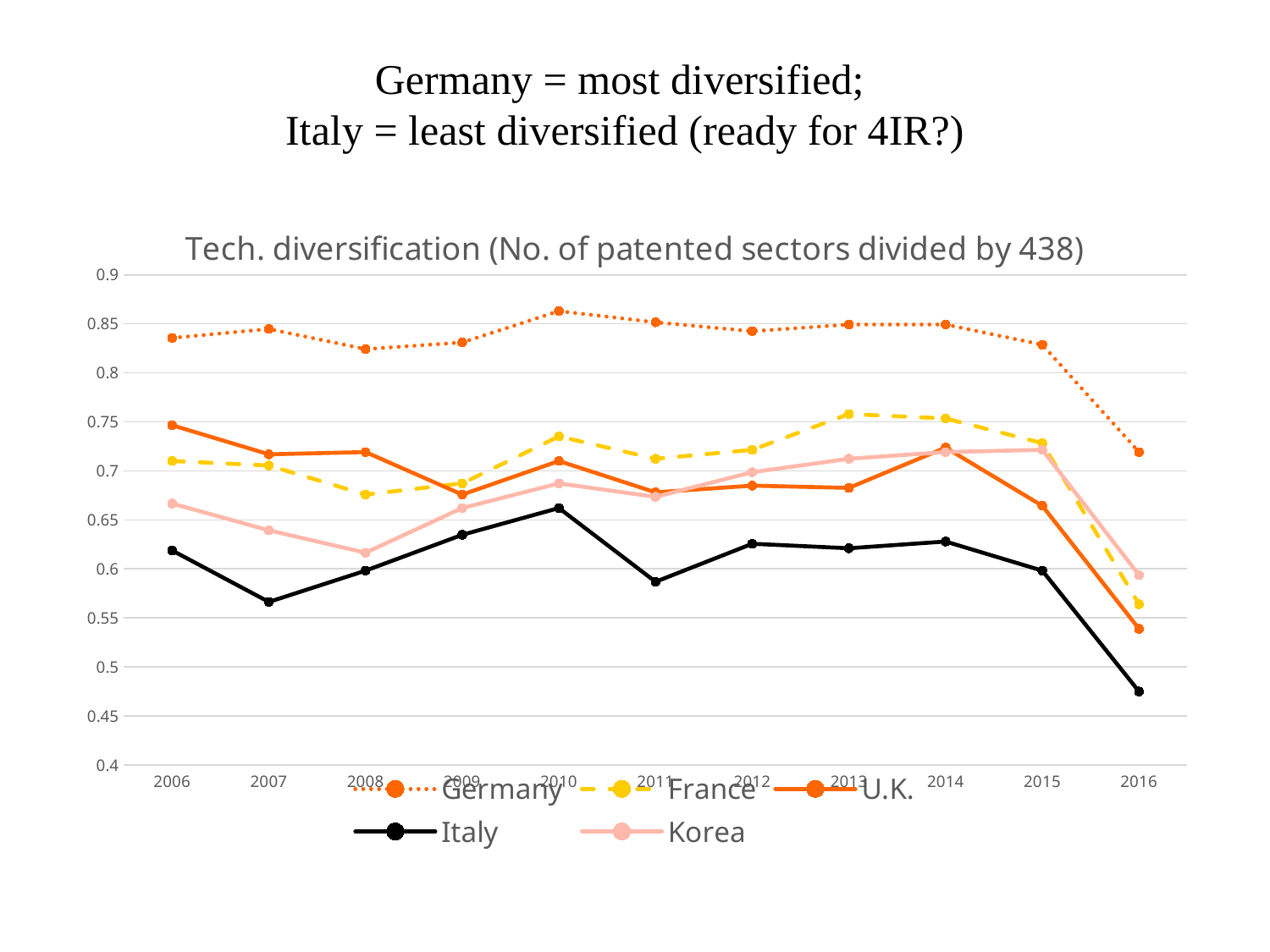
Which country has the highest value in 2012? Germany Is the value for Italy in 2016 greater or less than 0.5? less Which is larger in 2013, the value for France or the value for U.K.? France How many series does the legend list? 5 How many years are plotted along the x axis? 11 Is the value for Germany in 2016 greater or less than 0.75? less What kind of chart is shown on the slide? line chart Is the value for Germany in 2010 greater or less than 0.85? greater What is the title of the chart? Tech. diversification (No. of patented sectors divided by 438) Which country has the lowest value in 2016? Italy In which year does Italy reach its lowest value? 2016 Does the value for Italy rise or fall from 2015 to 2016? fall